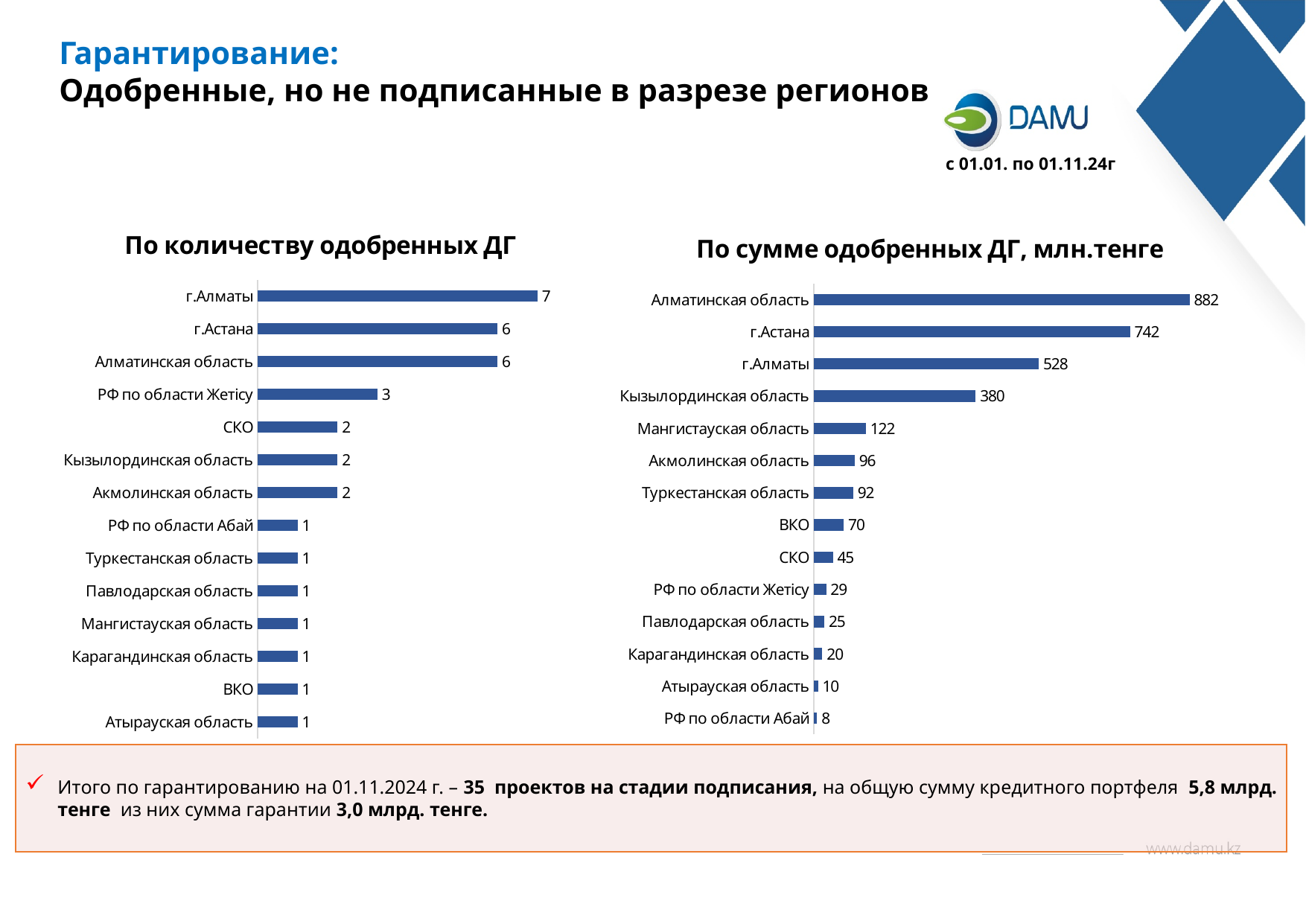
In the chart 'По количеству одобренных ДГ', what is the difference between г.Алматы and РФ по области Жетісу? 4 In the chart 'По сумме одобренных ДГ, млн.тенге', which region has the highest value? Алматинская область In the chart 'По сумме одобренных ДГ, млн.тенге', what is the value for ВКО? 70 In the chart 'По сумме одобренных ДГ, млн.тенге', what is the value for Кызылординская область? 380 How many categories are shown in the chart 'По количеству одобренных ДГ'? 14 In the chart 'По сумме одобренных ДГ, млн.тенге', which is larger: Мангистауская область or Акмолинская область? Мангистауская область What type of chart is 'По сумме одобренных ДГ, млн.тенге'? Bar chart In the chart 'По сумме одобренных ДГ, млн.тенге', what is the difference between Алматинская область and г.Астана? 140 How many categories are shown in the chart 'По сумме одобренных ДГ, млн.тенге'? 14 In the chart 'По количеству одобренных ДГ', which category has the highest value? г.Алматы In the chart 'По сумме одобренных ДГ, млн.тенге', which region has the lowest value? РФ по области Абай In the chart 'По количеству одобренных ДГ', what is the value for г.Алматы? 7